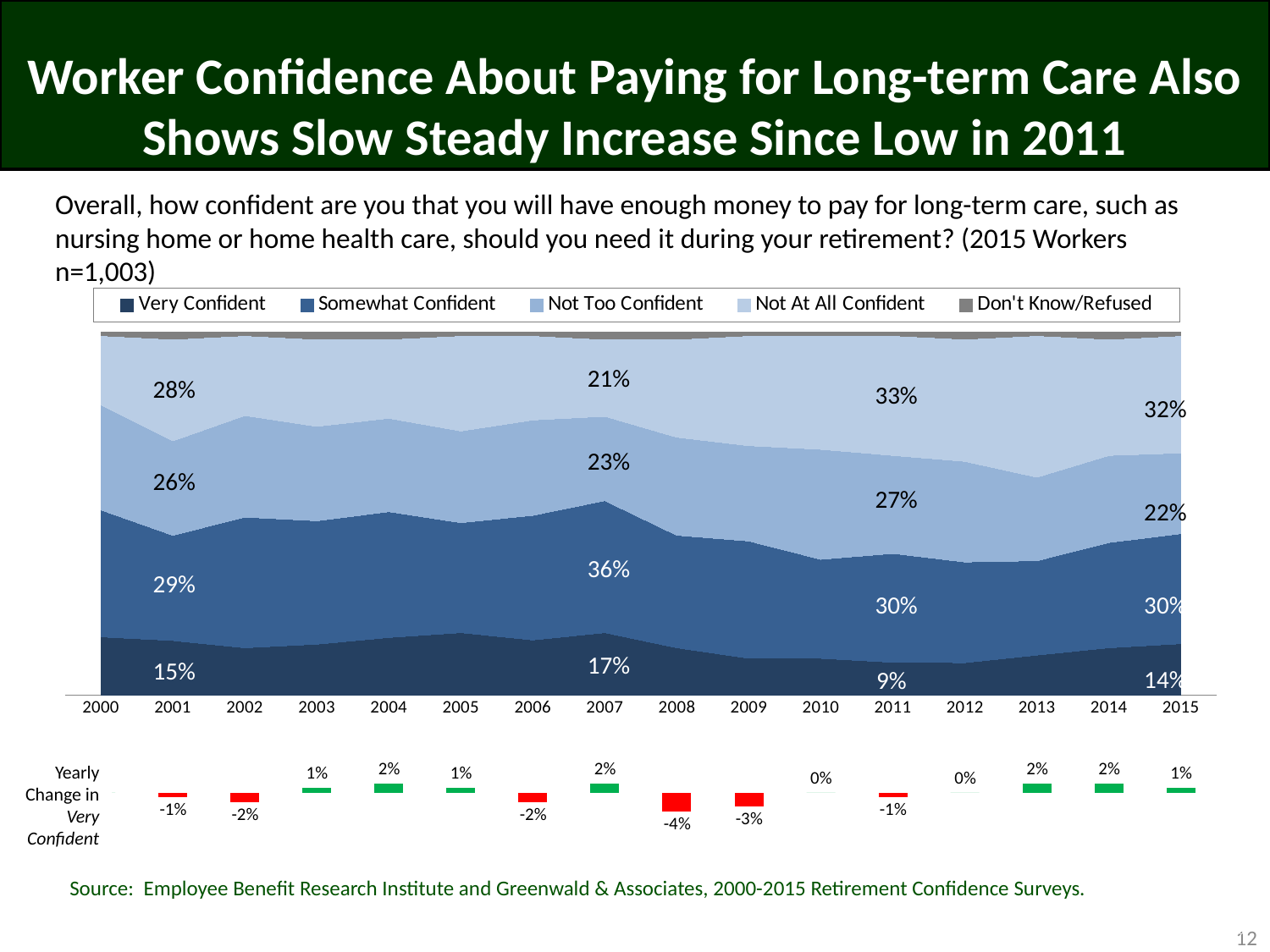
In the stacked area chart, what percentage of workers were Somewhat Confident in 2007? 36% In the stacked area chart, what percentage of workers were Very Confident in 2011? 9% In the Yearly Change in Very Confident bar chart, what colour are the bars for negative values? Red How many years are shown on the x axis of the stacked area chart? 16 How many series does the legend of the stacked area chart list? 5 In the stacked area chart, what is the difference between the Not At All Confident share in 2011 and in 2007? 12 percentage points In the stacked area chart, what percentage of workers were Not At All Confident in 2015? 32% What kind of chart is the Yearly Change in Very Confident chart at the bottom of the slide? Bar chart In the Yearly Change in Very Confident bar chart, which year has the lowest value? 2008 In the stacked area chart, which is larger: the Very Confident share in 2007 or in 2015? 2007 In the stacked area chart, what percentage of workers were Not Too Confident in 2001? 26% In the Yearly Change in Very Confident bar chart, what is the value for 2008? -4%